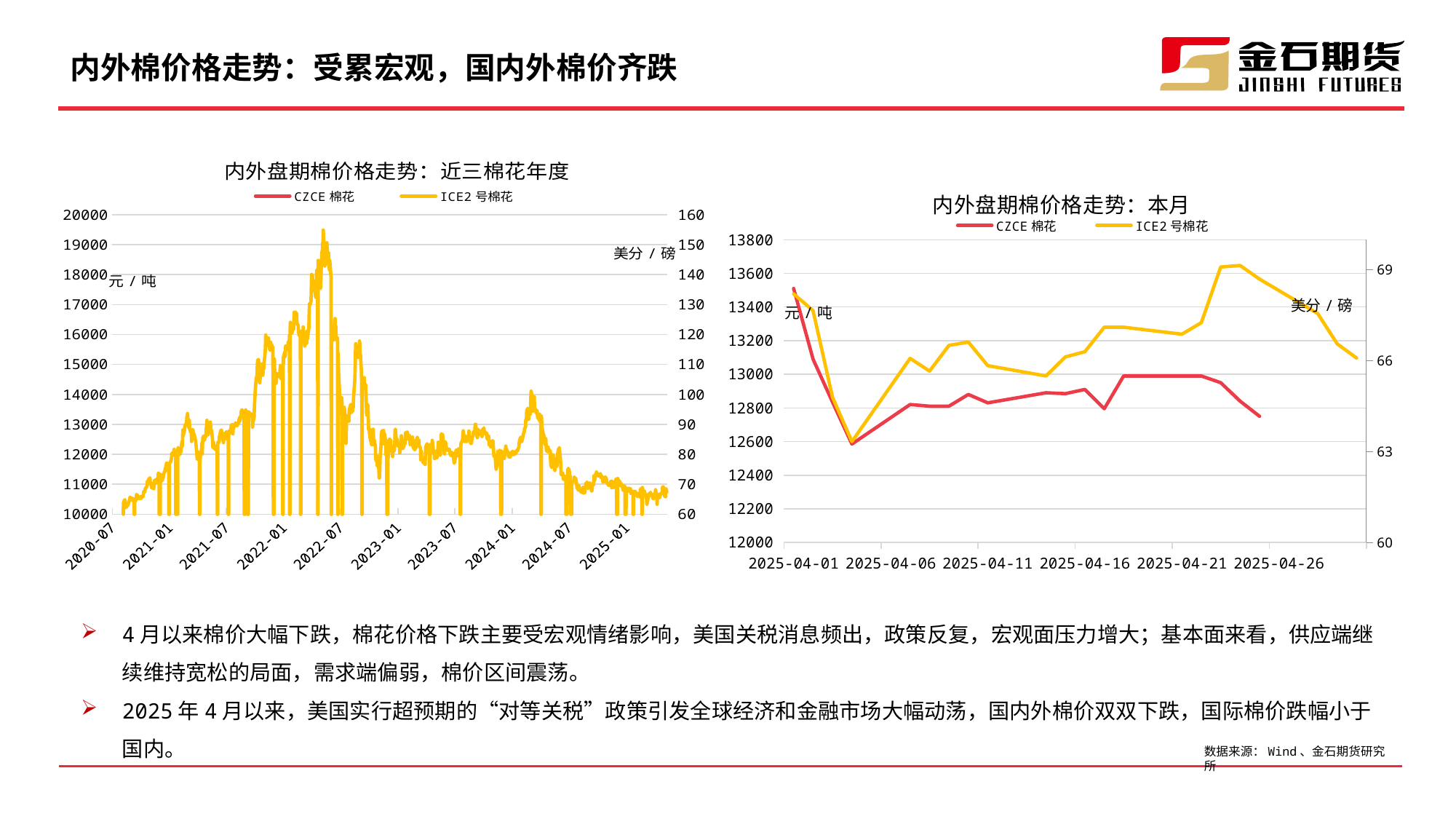
In the right chart (内外盘期棉价格走势：本月), is the CZCE 棉花 value at the last plotted point greater or less than 13000? less In the left chart (内外盘期棉价格走势：近三棉花年度), which series is drawn in yellow? ICE2号棉花 In the right chart (内外盘期棉价格走势：本月), is the ICE2号棉花 value on 2025-04-01 greater or less than 66? greater In the right chart (内外盘期棉价格走势：本月), what unit is shown on the left axis? 元/吨 How many series does the legend of the right chart (内外盘期棉价格走势：本月) list? 2 In the right chart (内外盘期棉价格走势：本月), does the CZCE 棉花 line rise or fall between 2025-04-01 and 2025-04-04? fall What kind of chart is the left chart titled 内外盘期棉价格走势：近三棉花年度? line chart In the right chart (内外盘期棉价格走势：本月), does the CZCE 棉花 line rise or fall from 2025-04-21 to the end of the series? fall In the left chart (内外盘期棉价格走势：近三棉花年度), does the ICE2号棉花 line overall rise or fall from its 2022 peak to 2025? fall In the right chart (内外盘期棉价格走势：本月), is the CZCE 棉花 value on 2025-04-01 greater or less than 13000? greater What kind of chart is the right chart titled 内外盘期棉价格走势：本月? line chart